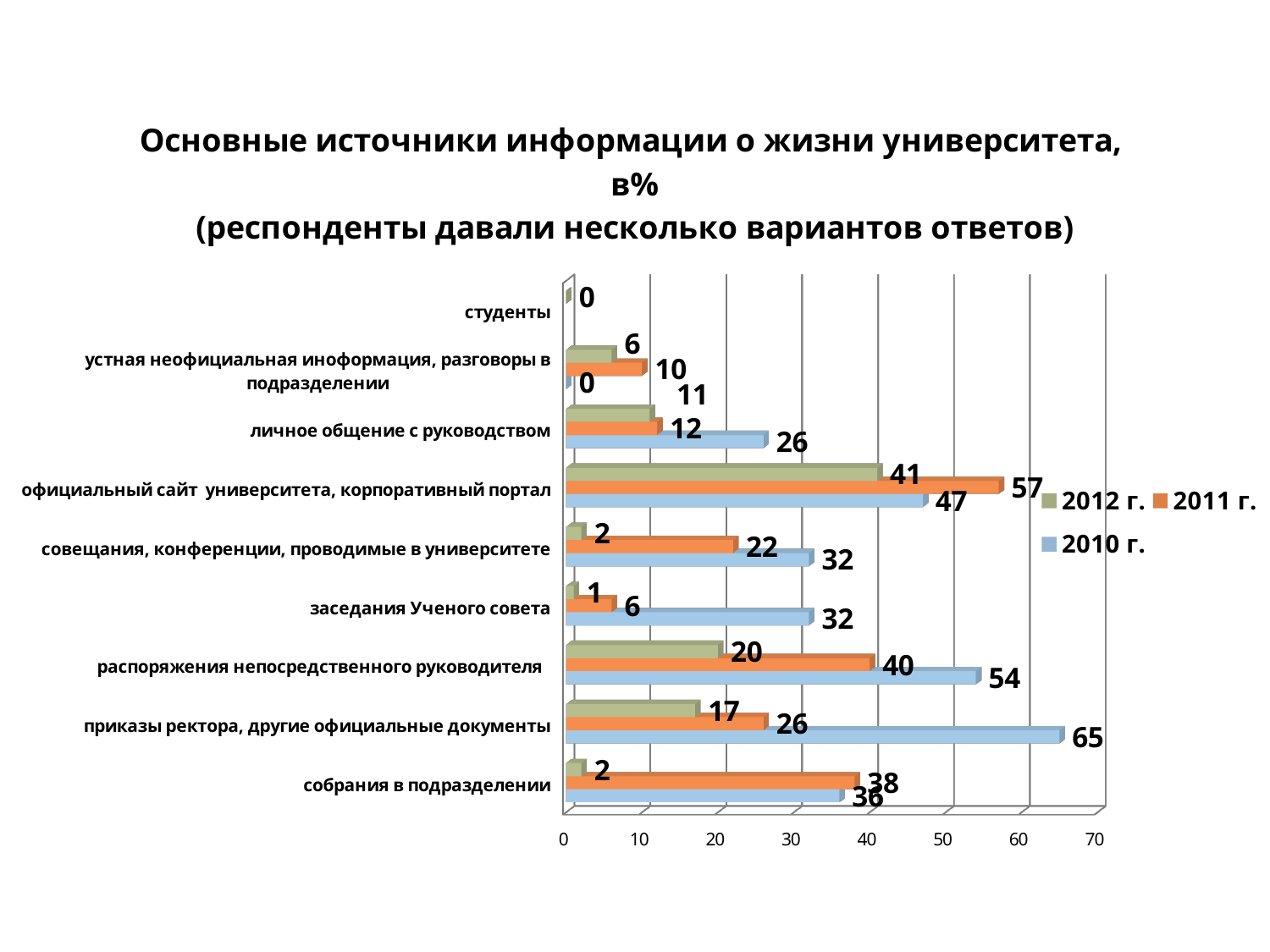
Is the 2011 г. value for 'распоряжения непосредственного руководителя' greater or less than 30? greater What is the value for 'распоряжения непосредственного руководителя' in the 2012 г. series? 20 Which series is shown in orange in the legend? 2011 г. What is the difference between the 2010 г. and 2012 г. values for 'приказы ректора, другие официальные документы'? 48 Which category has the highest value in the 2012 г. series? официальный сайт университета, корпоративный портал Which category has the highest value in the 2010 г. series? приказы ректора, другие официальные документы What is the value for 'официальный сайт университета, корпоративный портал' in the 2011 г. series? 57 For 'совещания, конференции, проводимые в университете', which series has the larger value: 2011 г. or 2010 г.? 2010 г. How many series does the legend list? 3 How many categories are shown on the chart? 9 What is the value for 'приказы ректора, другие официальные документы' in the 2010 г. series? 65 What type of chart is shown on the slide? bar chart